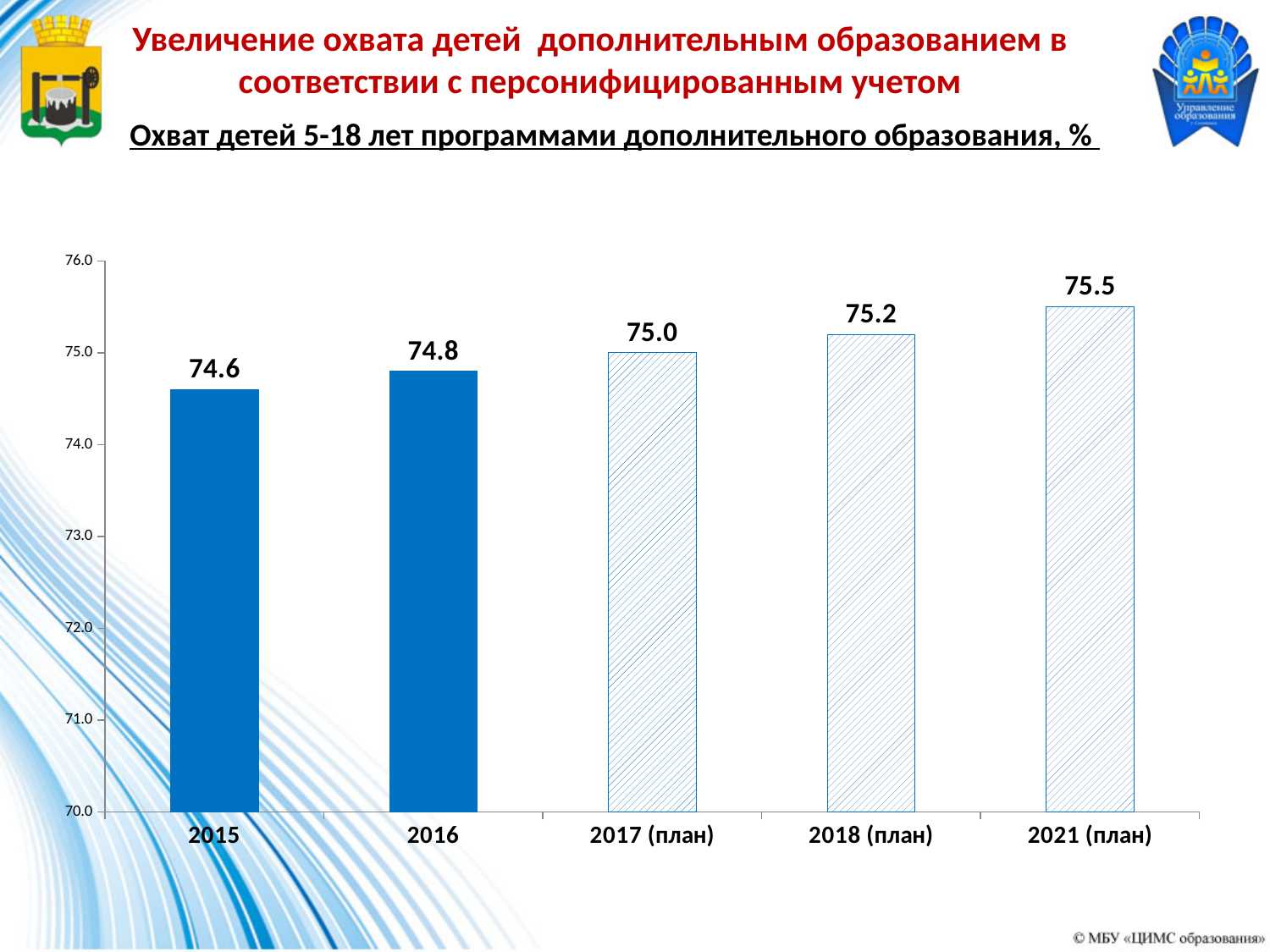
What is the value for 2015? 74.6 What is the difference between the values for 2018 (план) and 2017 (план)? 0.2 Which category has the highest value? 2021 (план) What is the value for 2017 (план)? 75.0 What is the difference between the values for 2021 (план) and 2015? 0.9 What is the value for 2021 (план)? 75.5 How many categories are shown on the x axis? 5 Which is larger, the value for 2016 or the value for 2018 (план)? 2018 (план) What kind of chart is shown on the slide? bar chart Which category has the lowest value? 2015 Do the values rise or fall from 2015 to 2021 (план)? rise What is the value for 2016? 74.8